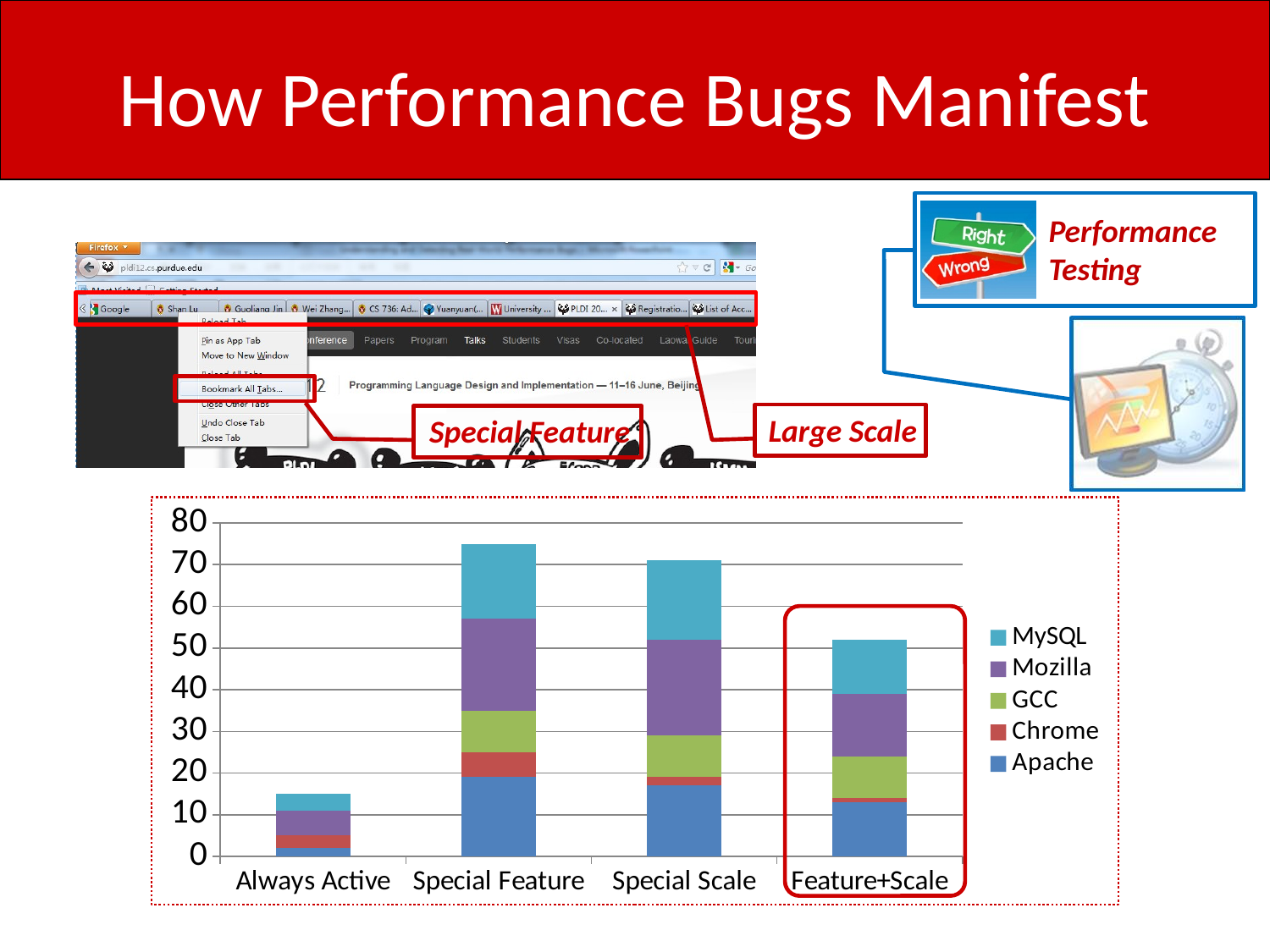
How many series does the chart's legend list? 5 Is the total stacked value for Special Scale greater or less than 60? greater What kind of chart is shown on the slide? Stacked bar chart Which has the larger total stacked value, Always Active or Feature+Scale? Feature+Scale Which category has the tallest stacked bar in the chart? Special Feature Which series is listed first (at the top) in the chart's legend? MySQL How many categories are shown on the x axis of the chart? 4 Is the total stacked value for Always Active greater or less than 20? less Is the total stacked value for Special Feature greater or less than 70? greater Which category has the shortest stacked bar in the chart? Always Active Which category's bar is highlighted with a red rounded outline on the chart? Feature+Scale